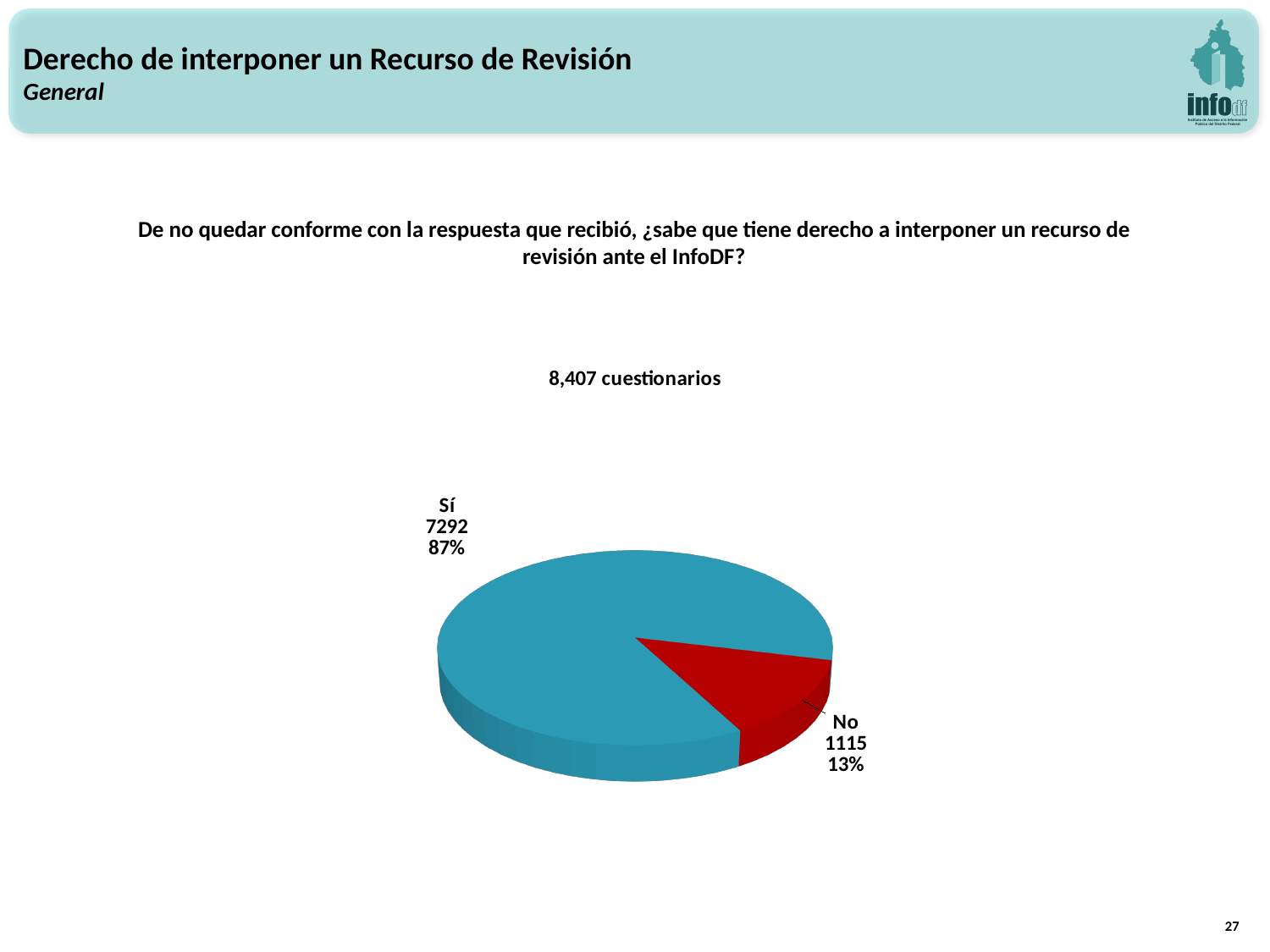
What colour is the "No" slice? red Which slice is the largest? Sí What is the difference between the "Sí" and "No" values? 6177 What kind of chart is shown on the slide? pie chart What share of the pie does the "No" slice represent? 13% How many slices does the pie chart have? 2 What is the value for the "No" slice? 1115 Which is larger, the "Sí" slice or the "No" slice? Sí What is the value for the "Sí" slice? 7292 How many questionnaires does the chart subtitle say were counted? 8,407 cuestionarios What share of the pie does the "Sí" slice represent? 87% Which slice is the smallest? No